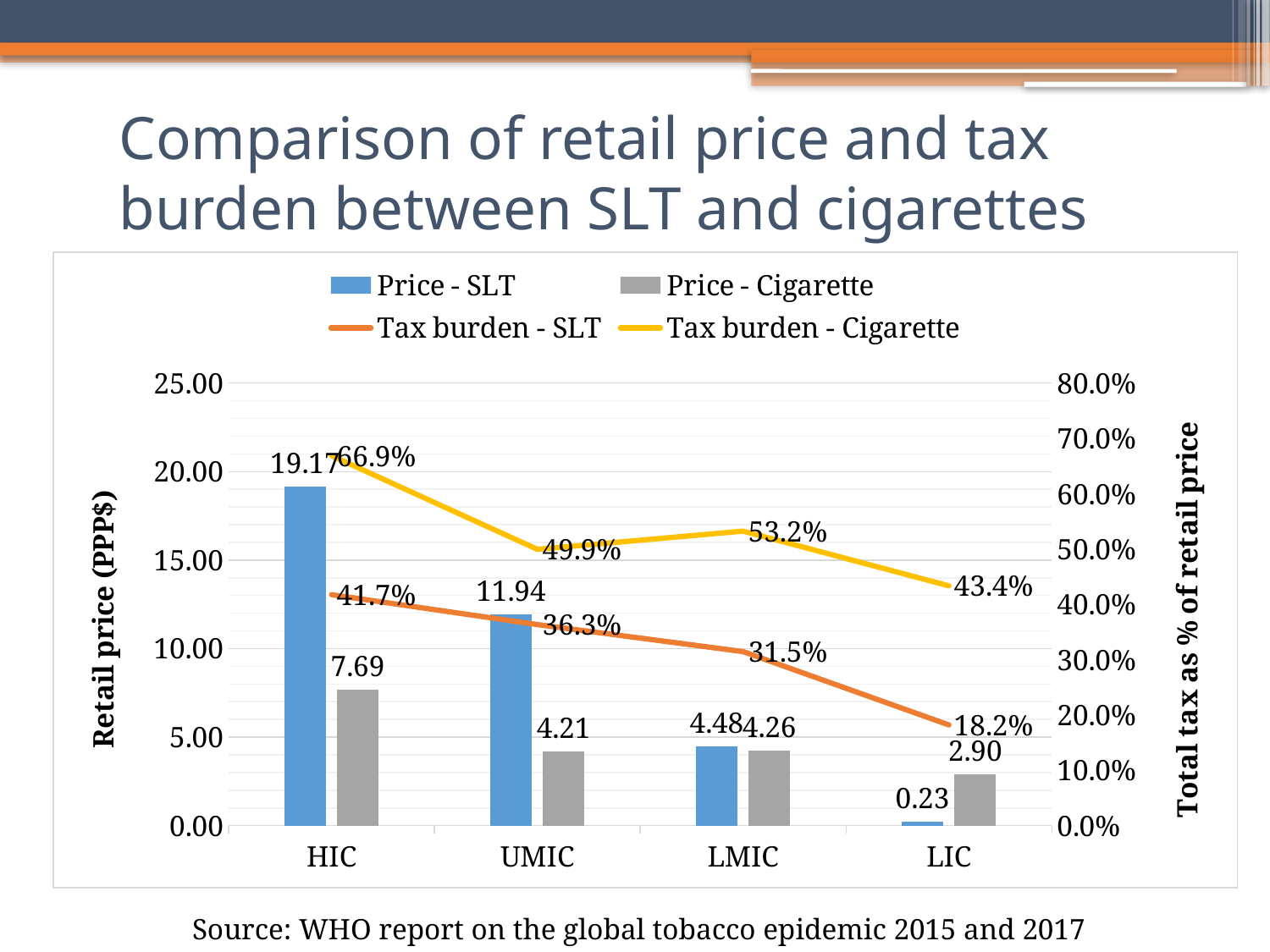
How many series does the legend list? 4 How many categories are shown on the x axis? 4 What is the Price - SLT value for HIC? 19.17 Which is larger for LMIC, the Tax burden - Cigarette value or the Tax burden - SLT value? Tax burden - Cigarette What is the Tax burden - SLT value for LIC? 18.2% Does the Tax burden - SLT line rise or fall from HIC to LIC? fall What is the label of the right-hand vertical axis? Total tax as % of retail price What is the Tax burden - Cigarette value for UMIC? 49.9% Which category has the lowest Tax burden - SLT value? LIC What is the difference between the Price - SLT and Price - Cigarette values for HIC? 11.48 Which category has the highest Price - SLT value? HIC What is the Price - Cigarette value for LIC? 2.90